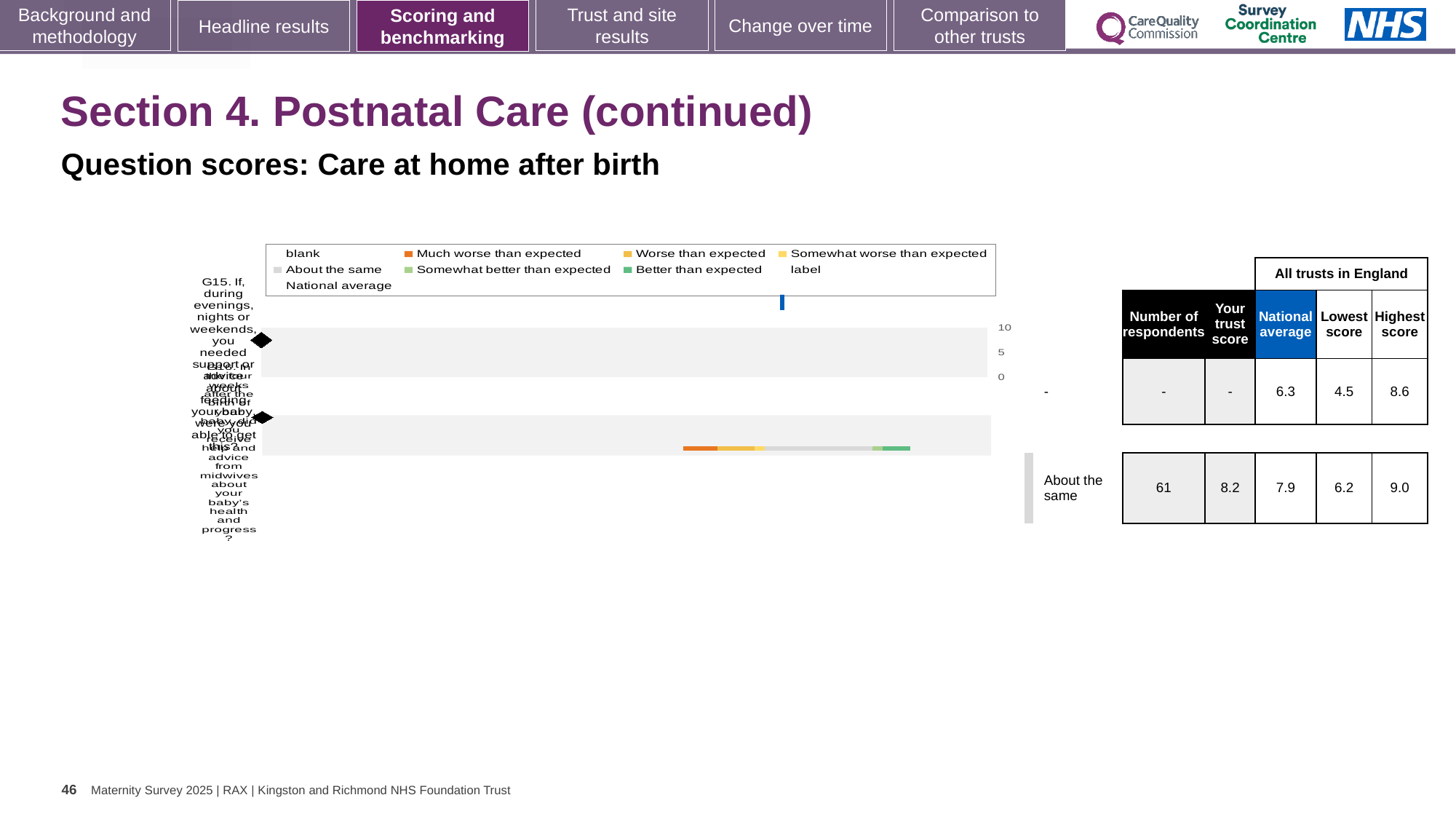
In the table beside the chart, what is the highest score for the second question row? 9.0 What kind of chart is shown on the slide? bar chart In the table beside the chart, what is the trust score for the second question row? 8.2 What is the maximum value shown on the chart's score axis? 10 In the table beside the chart, what is the national average for the first question row? 6.3 In the table beside the chart, what is the national average for the second question row? 7.9 For the second question row, what is the difference between the highest score and the lowest score? 2.8 How many entries does the chart legend list? 9 For the second question row, which is larger: the trust score or the national average? trust score In the table beside the chart, what is the number of respondents for the second question row? 61 What benchmark category is shown for the second question row? About the same In the table beside the chart, what is the lowest score for the first question row? 4.5